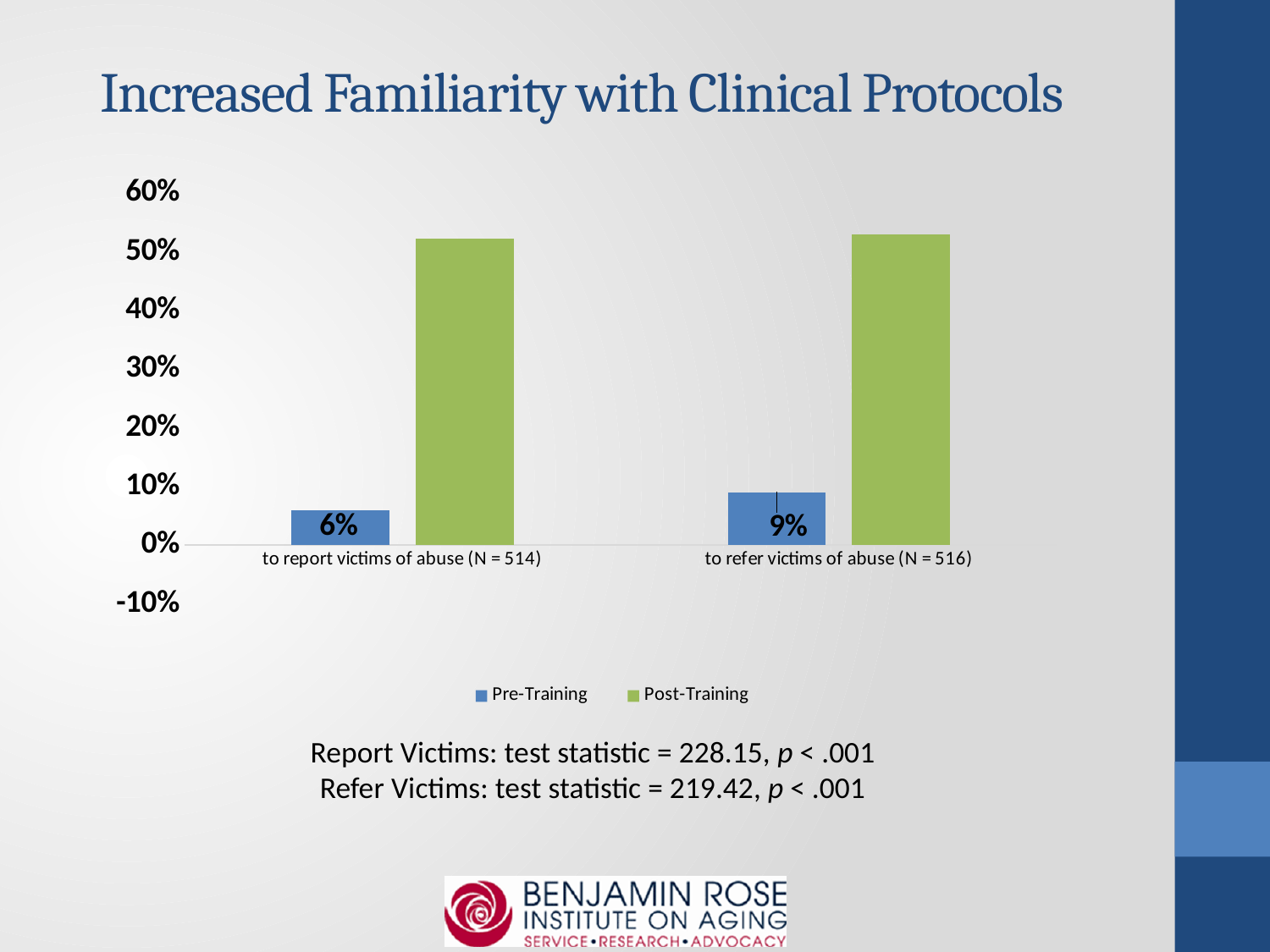
How many series does the chart's legend list? 2 Which category has the lowest Pre-Training value? to report victims of abuse (N = 514) What kind of chart is shown on the slide? bar chart Is the Post-Training value for "to report victims of abuse (N = 514)" greater or less than 50%? greater What is the difference between the Pre-Training values for referring victims of abuse and reporting victims of abuse? 3 percentage points For "to report victims of abuse (N = 514)", which is larger: the Pre-Training or the Post-Training value? Post-Training How many categories are shown on the x axis of the chart? 2 Which category has the higher Pre-Training value? to refer victims of abuse (N = 516) What is the Pre-Training value for "to report victims of abuse (N = 514)"? 6% Is the Post-Training value for "to refer victims of abuse (N = 516)" greater or less than 60%? less What is the Pre-Training value for "to refer victims of abuse (N = 516)"? 9% What are the two series named in the chart's legend? Pre-Training and Post-Training